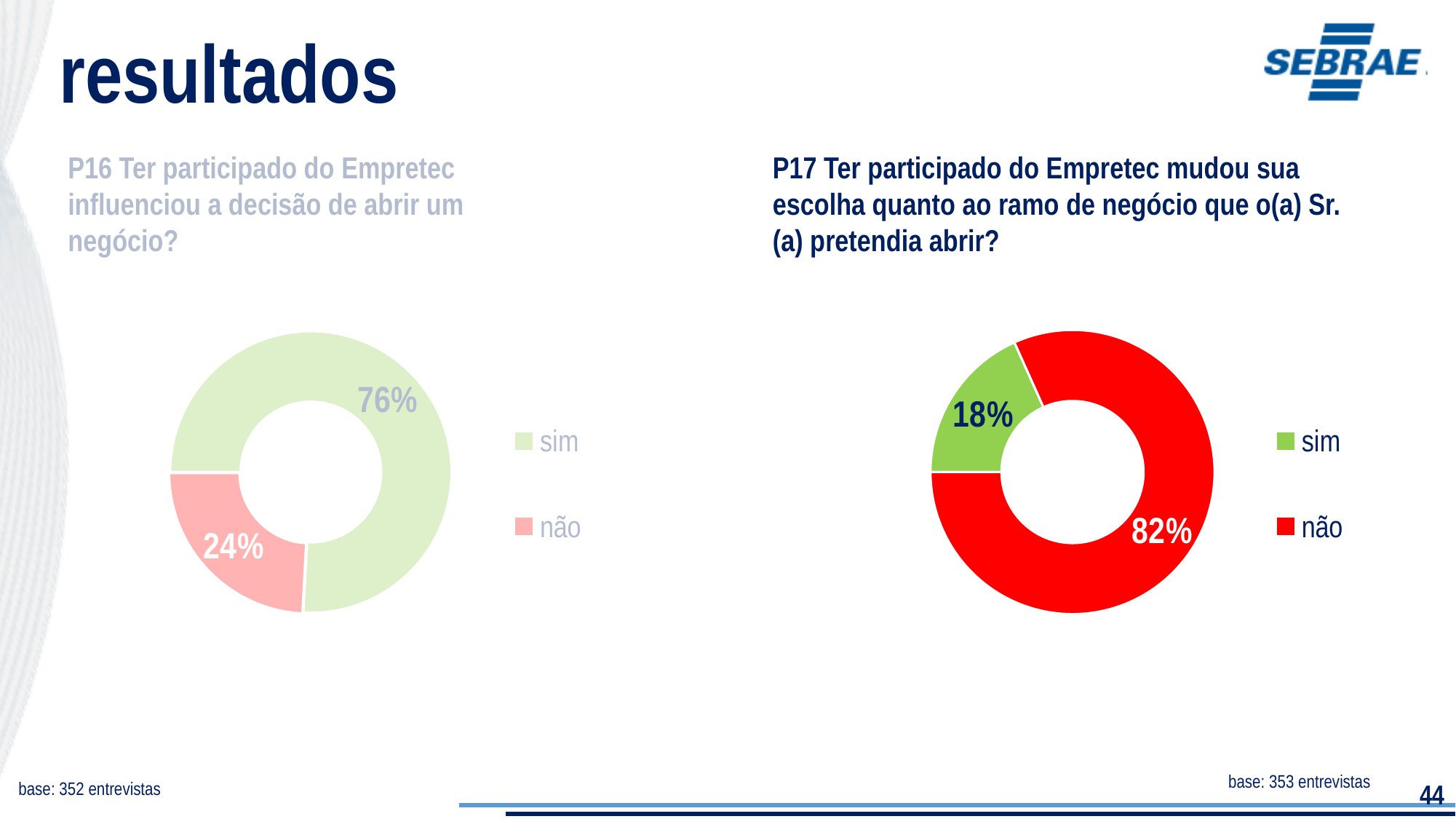
In the right chart (P17), what colour represents "não"? red In the left chart (P16), what is the difference in percentage points between "sim" and "não"? 52 In the right chart (P17), what percentage answered "não"? 82% In the left chart (P16), which answer has the largest share? sim In the left chart (P16), what percentage answered "sim"? 76% How many categories does the legend of the left chart (P16) list? 2 In the right chart (P17), what percentage answered "sim"? 18% In the left chart (P16), what percentage answered "não"? 24% In the right chart (P17), which answer has the smallest share? sim What type of chart is used on the right side of the slide (P17)? pie chart (doughnut) Which is larger: the "sim" share in the left chart (P16) or the "sim" share in the right chart (P17)? left chart (P16) In the right chart (P17), what is the difference in percentage points between "não" and "sim"? 64